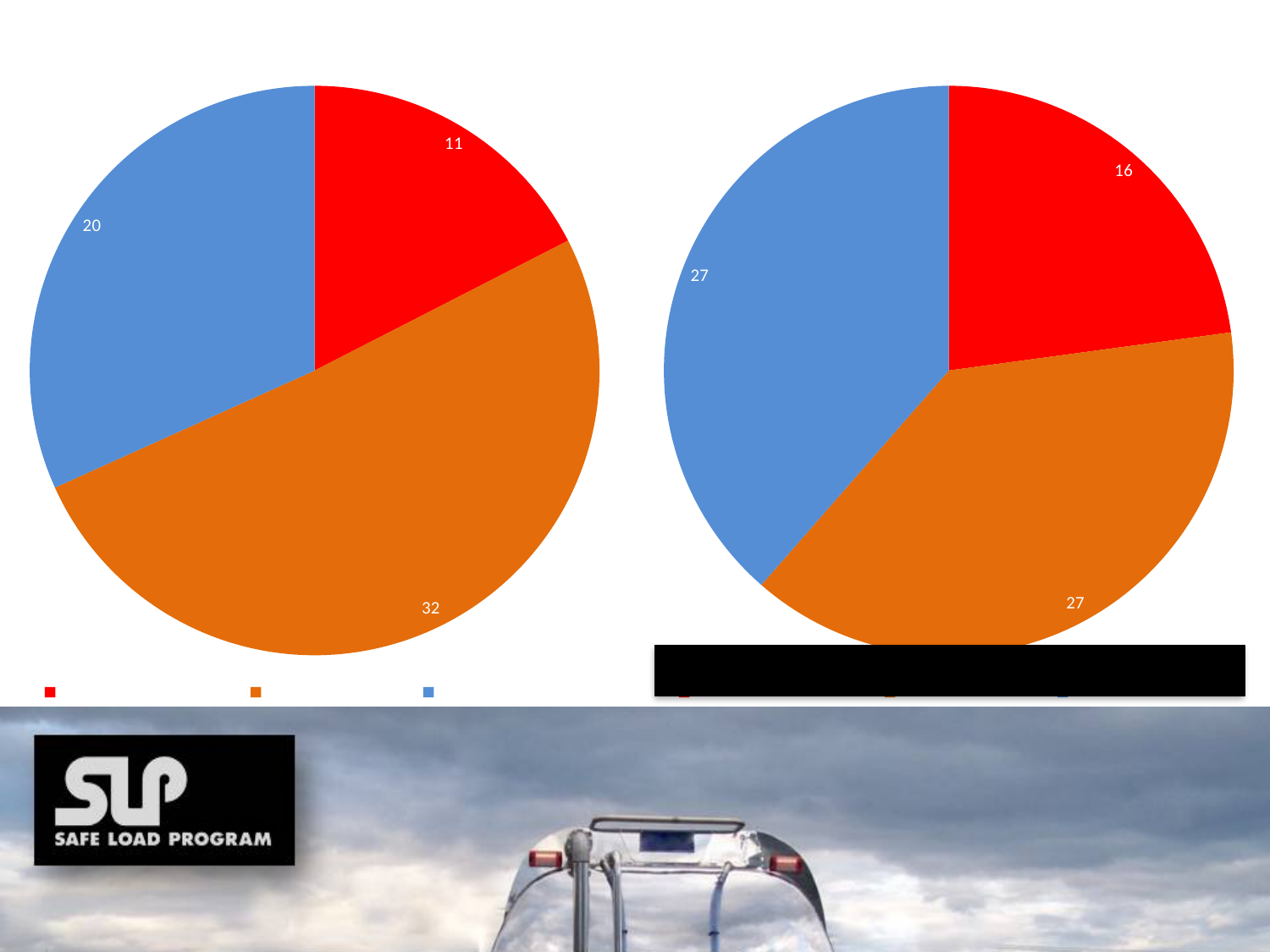
In the right pie chart, what is the value of the blue slice? 27 In the left pie chart, what is the difference between the orange slice and the blue slice? 12 How many slices does the right pie chart have? 3 In the right pie chart, which colour slice has the smallest value? Red In the right pie chart, what is the value of the red slice? 16 In the left pie chart, what is the value of the red slice? 11 In the left pie chart, which colour slice has the smallest value? Red In the left pie chart, what is the value of the orange slice? 32 What type of chart is shown on the left of the slide? Pie chart What is the total of all slices in the left pie chart? 63 In the right pie chart, is the orange slice or the red slice larger? Orange In the left pie chart, which colour slice has the largest value? Orange